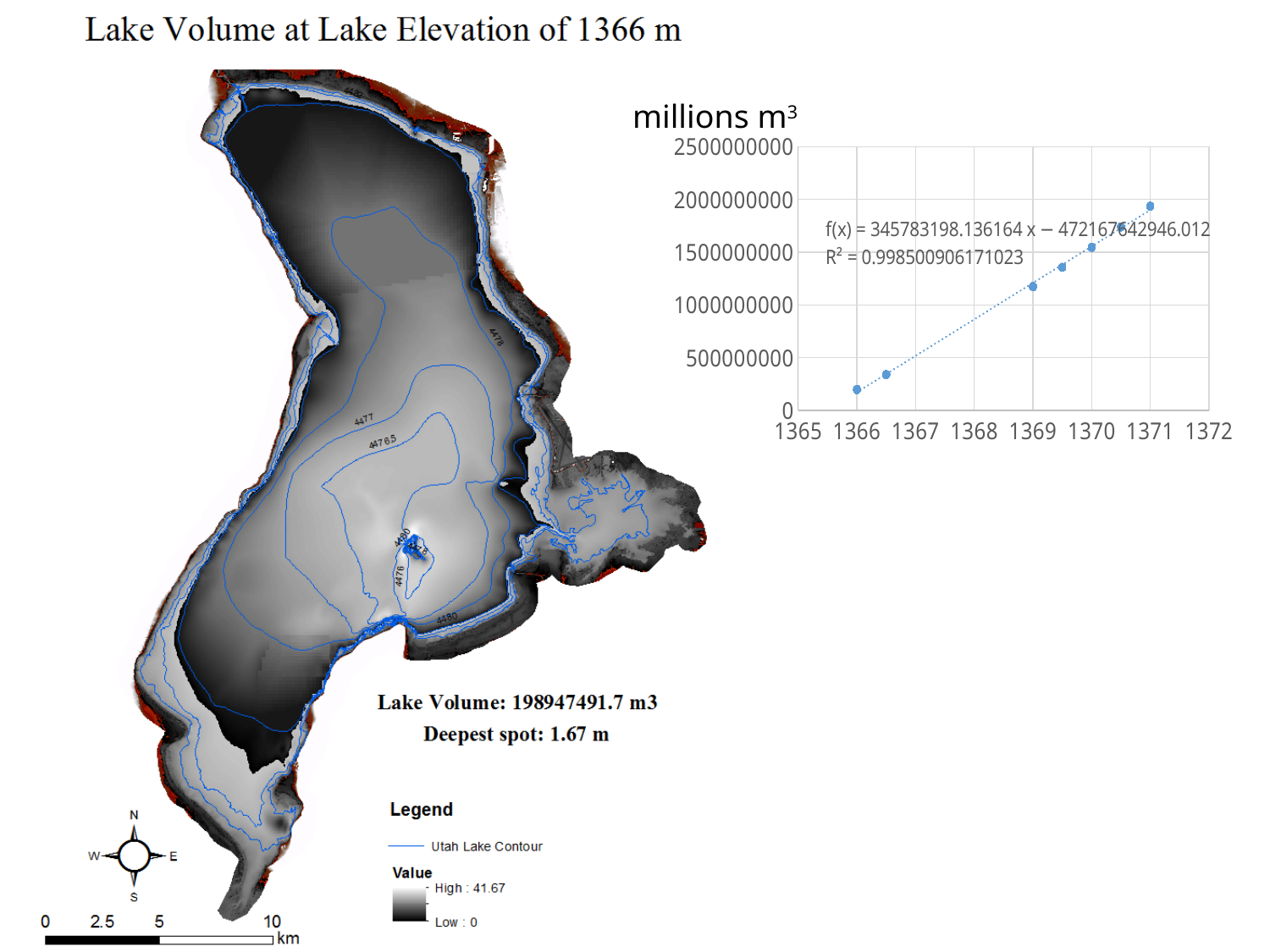
What R² value is printed on the scatter chart? 0.998500906171023 On the scatter chart, is the value at elevation 1369.5 greater or less than 1500000000? less On the scatter chart, is the value at elevation 1366 greater or less than 500000000? less On the scatter chart, at which x-axis elevation is the lowest plotted value? 1366 What kind of chart is shown on the right of the slide? scatter chart On the scatter chart, at which x-axis elevation is the highest plotted value? 1371 What unit label is shown above the y axis of the scatter chart? millions m³ On the scatter chart, do the values rise or fall as the elevation on the x axis increases? rise On the scatter chart, is the value at elevation 1371 greater or less than 1500000000? greater On the scatter chart, which has the larger value: the point at elevation 1366 or the point at elevation 1371? 1371 How many data points are plotted on the scatter chart? 7